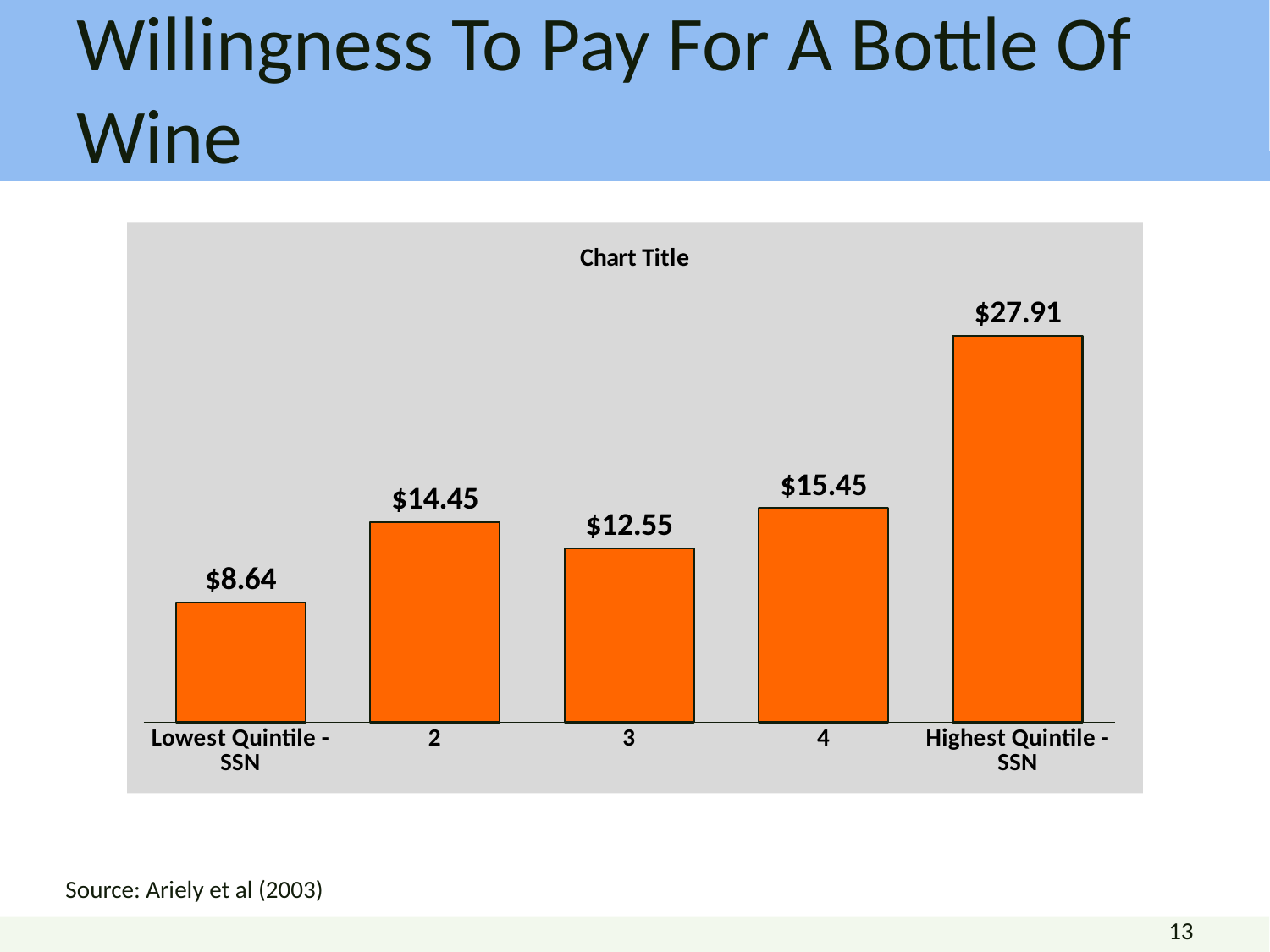
What is the willingness to pay for quintile 3? $12.55 What is the value shown for quintile 4? $15.45 What colour are the bars in the chart? Orange Which category has the lowest willingness to pay? Lowest Quintile - SSN What is the difference between the values for quintile 2 and quintile 3? $1.90 What is the willingness to pay for the Lowest Quintile - SSN? $8.64 What is the difference between the Highest Quintile - SSN and the Lowest Quintile - SSN values? $19.27 Which is larger, the value for quintile 2 or quintile 4? 4 Which category has the highest willingness to pay? Highest Quintile - SSN What is the willingness to pay for the Highest Quintile - SSN? $27.91 What kind of chart is shown on the slide? Bar chart How many categories are shown on the x axis? 5